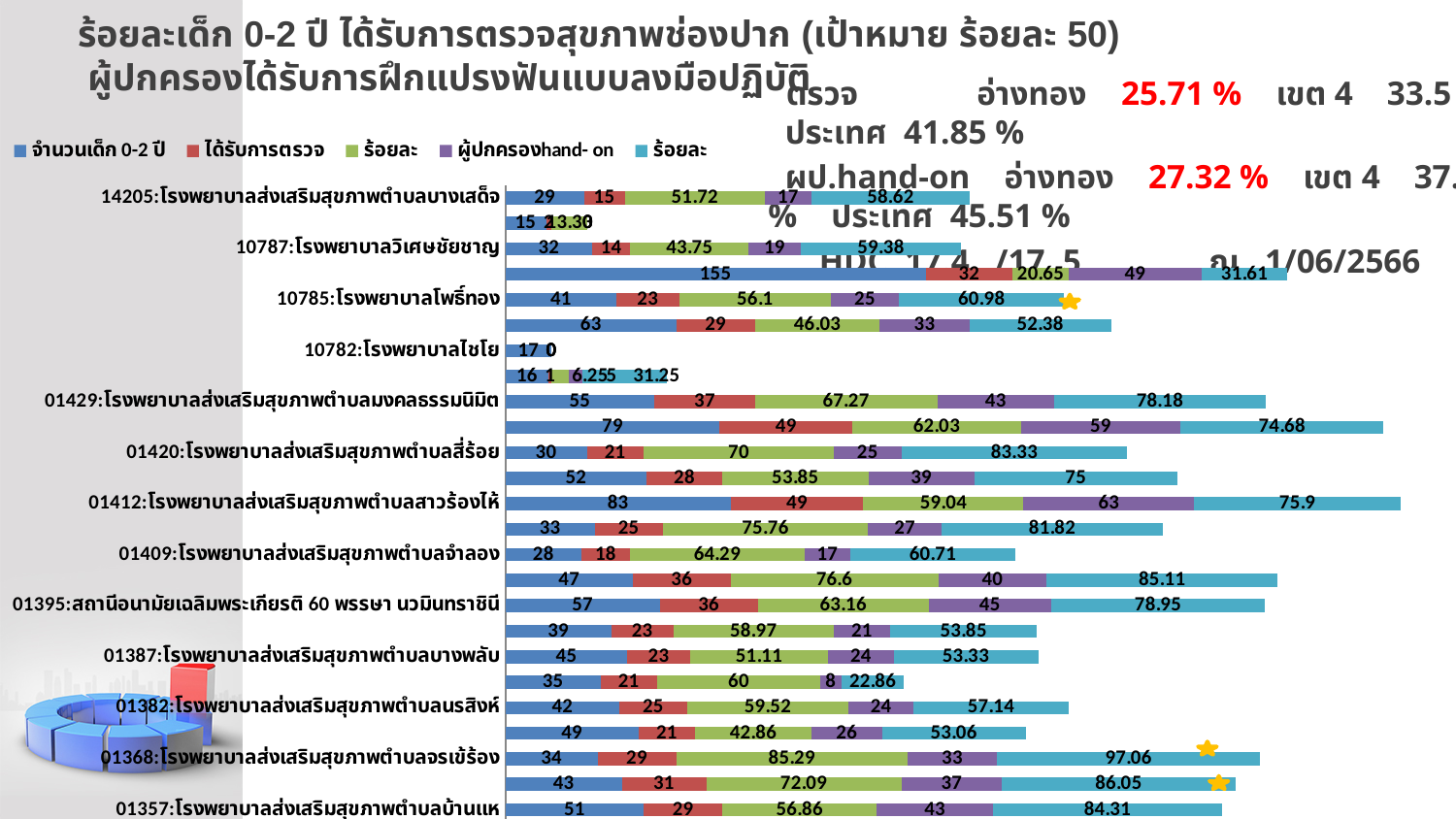
What kind of chart is shown on the slide? bar chart What is the first series listed in the legend? จำนวนเด็ก 0-2 ปี What is the value of ได้รับการตรวจ for 01429:โรงพยาบาลส่งเสริมสุขภาพตำบลมงคลธรรมนิมิต? 37 What is the value of the last (teal) ร้อยละ series for 01357:โรงพยาบาลส่งเสริมสุขภาพตำบลบ้านแห? 84.31 What is the value of the green ร้อยละ series for 01368:โรงพยาบาลส่งเสริมสุขภาพตำบลจรเข้ร้อง? 85.29 What is the value of ผู้ปกครองhand- on for 10785:โรงพยาบาลโพธิ์ทอง? 25 What is the value of จำนวนเด็ก 0-2 ปี for 01412:โรงพยาบาลส่งเสริมสุขภาพตำบลสาวร้องไห้? 83 For 01412:โรงพยาบาลส่งเสริมสุขภาพตำบลสาวร้องไห้, what is the difference between จำนวนเด็ก 0-2 ปี and ได้รับการตรวจ? 34 How many series does the legend list? 5 Which has a larger จำนวนเด็ก 0-2 ปี value: 01412:โรงพยาบาลส่งเสริมสุขภาพตำบลสาวร้องไห้ or 01429:โรงพยาบาลส่งเสริมสุขภาพตำบลมงคลธรรมนิมิต? 01412:โรงพยาบาลส่งเสริมสุขภาพตำบลสาวร้องไห้ What is the value of ได้รับการตรวจ for 10782:โรงพยาบาลไชโย? 0 What is the value of ผู้ปกครองhand- on for 01395:สถานีอนามัยเฉลิมพระเกียรติ 60 พรรษา นวมินทราชินี? 45